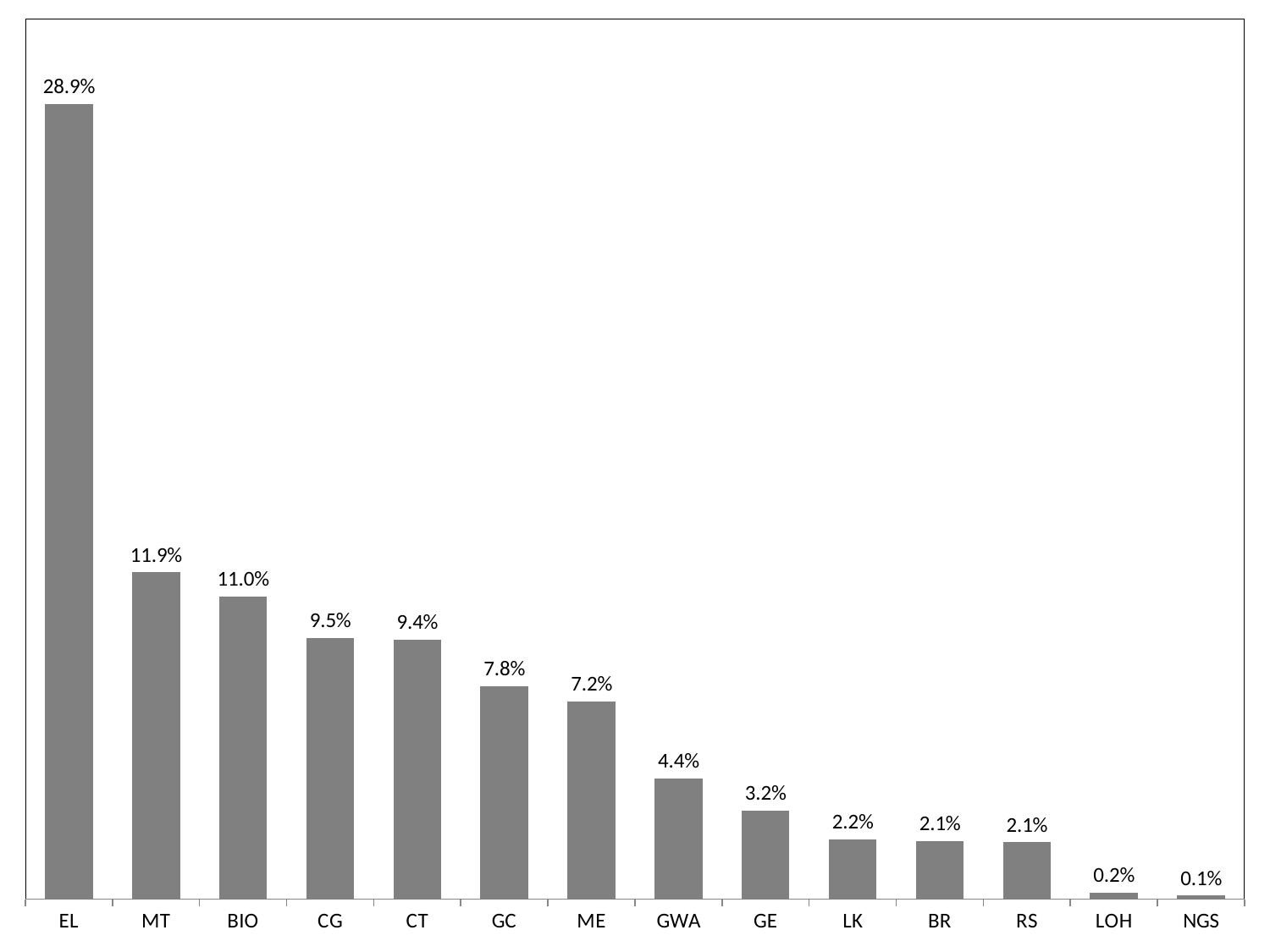
What is the value for GWA? 4.4% Which category has the lowest value? NGS What is the value for EL? 28.9% Which category has the highest value? EL What is the difference between the values for MT and BIO? 0.9% Do the values rise or fall from left to right along the x axis? Fall What kind of chart is this? Bar chart Which is larger, the value for GE or the value for GWA? GWA Which is larger, the value for GC or the value for ME? GC How many categories are shown on the x axis? 14 What is the difference between the values for EL and MT? 17.0% What is the value for LOH? 0.2%